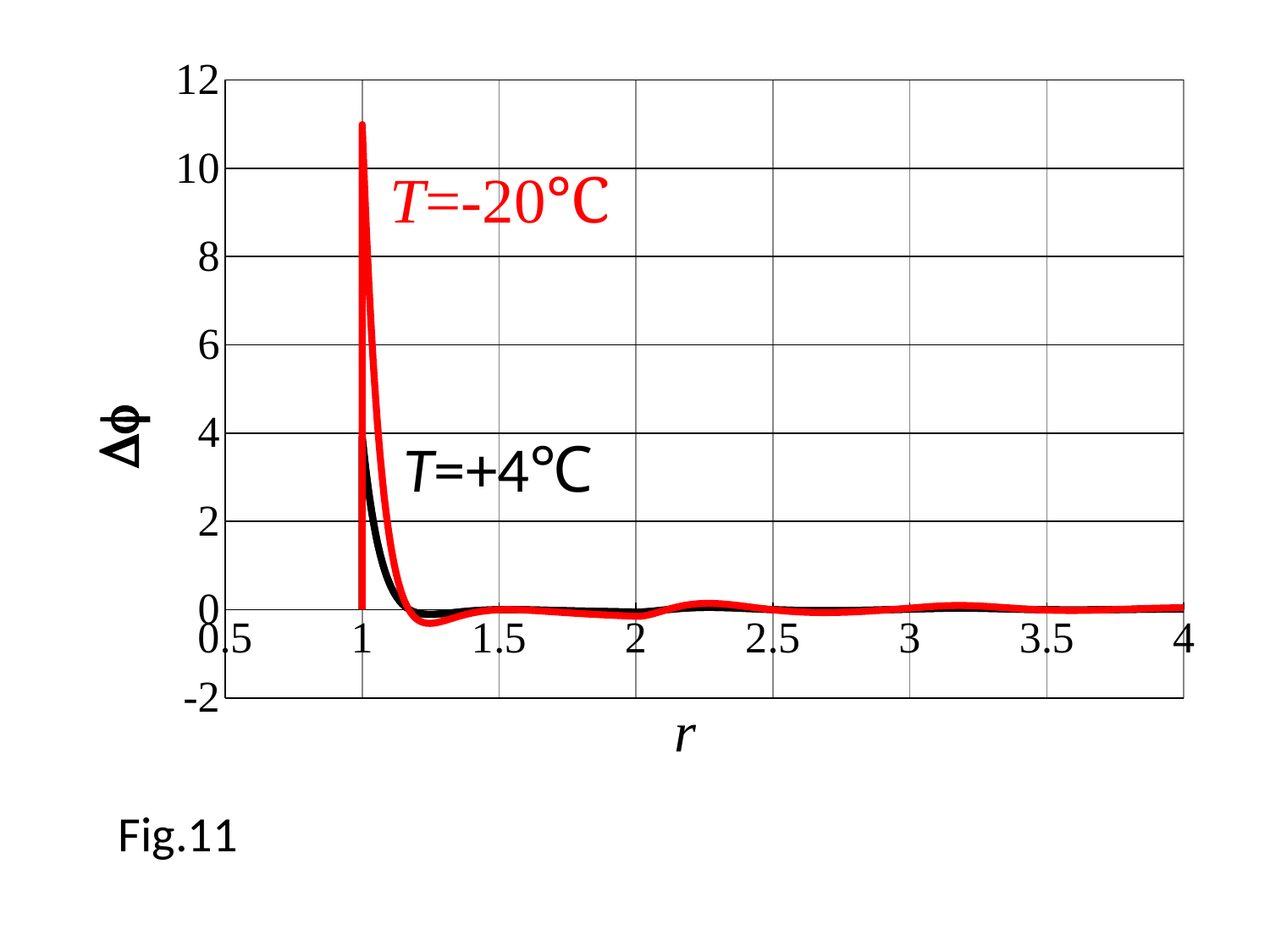
What kind of chart is shown on the slide? line chart What is the label on the x axis of the chart? r Is the peak value of Δφ for the T=+4°C series greater or less than 2? greater Is the peak value of Δφ for the T=-20°C series greater or less than 12? less After the peak at r=1, do the Δφ values rise or fall as r increases toward 1.5? fall Which series has the higher peak value of Δφ, T=-20°C or T=+4°C? T=-20°C What is the maximum value shown on the y axis? 12 At which value of r do both curves reach their peak? 1 What colour is the line for the T=-20°C series? red Is the peak value of Δφ for the T=+4°C series greater or less than 6? less How many series are plotted on the chart? 2